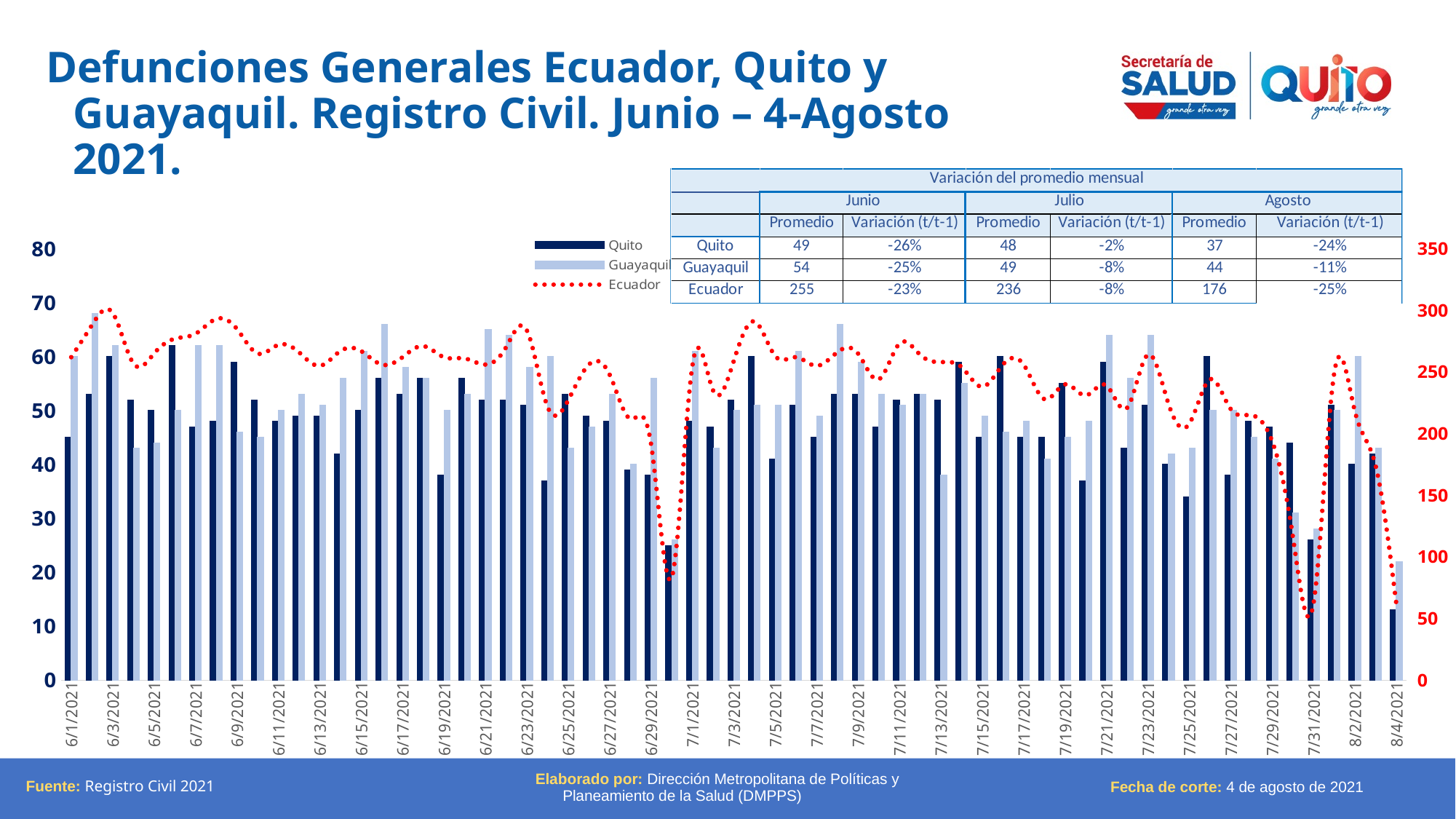
Is the Quito value for 6/1/2021 greater or less than 40? greater Is the Quito value for 8/4/2021 greater or less than 20? less Is the Ecuador value for 6/29/2021 greater or less than 100 on the right-hand axis? greater On 6/1/2021, which bar is taller, Quito or Guayaquil? Guayaquil How many series does the chart legend list? 3 What is the maximum value shown on the right-hand axis of the chart? 350 Which series is drawn as a red dotted line in the chart? Ecuador On 7/3/2021, which bar is taller, Quito or Guayaquil? Quito What kind of chart is shown on the slide? A bar chart combined with a dotted line